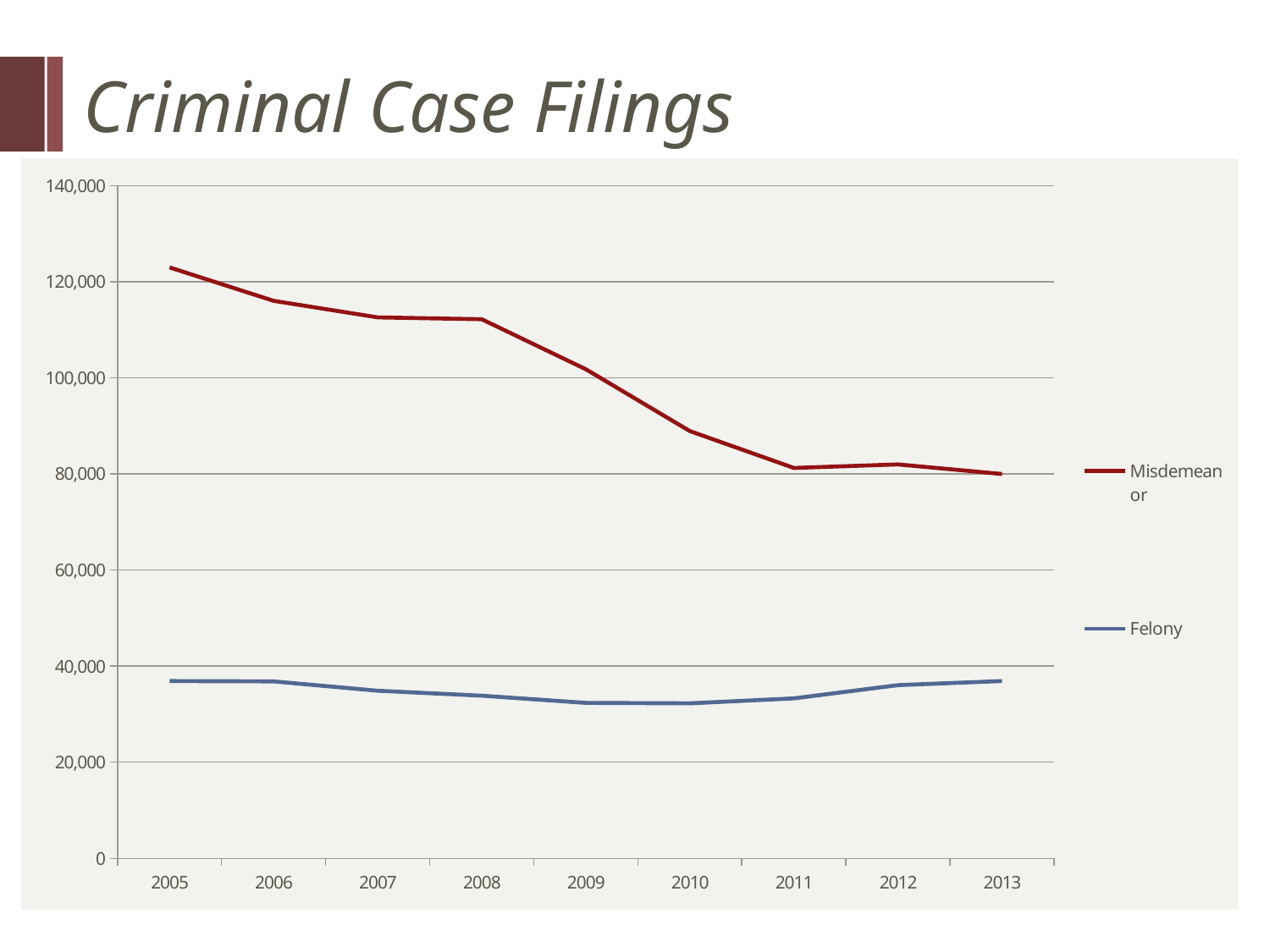
Is the Felony value for 2009 greater or less than 40,000? less What is the title of the slide? Criminal Case Filings How many series does the legend list? 2 Is the Misdemeanor value for 2008 greater or less than 100,000? greater How many years are plotted along the x axis? 9 Is the Misdemeanor value for 2010 greater or less than 100,000? less In which year is the Misdemeanor series at its highest? 2005 What kind of chart is shown on the slide? line chart In 2013, which series has the larger value, Misdemeanor or Felony? Misdemeanor Do Misdemeanor filings rise or fall from 2005 to 2013? fall Which series is drawn in dark red? Misdemeanor